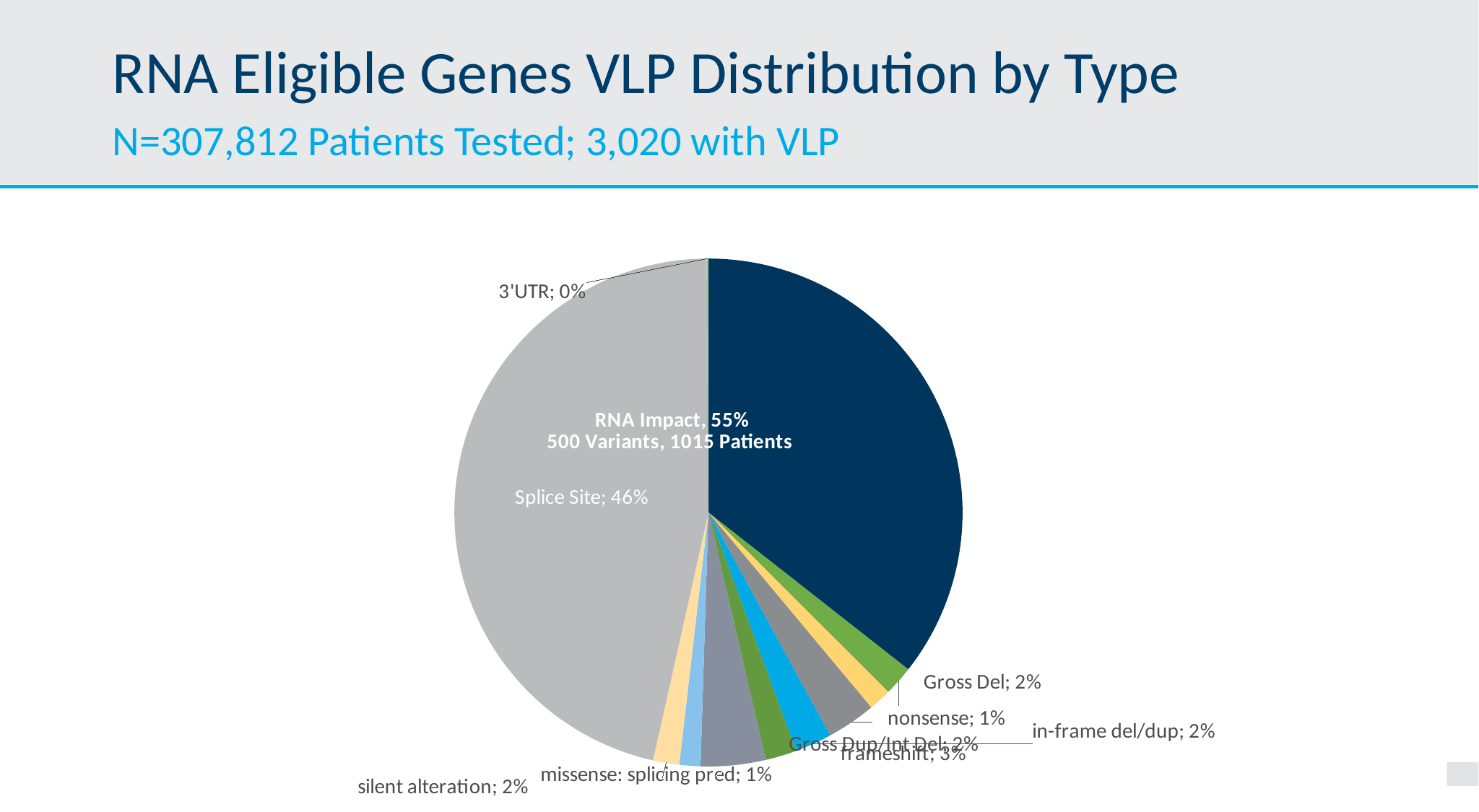
What percentage is shown for frameshift? 3% What percentage is shown for nonsense? 1% What percentage is shown for 3'UTR? 0% What percentage of the pie is labelled Splice Site? 46% What is the difference in percentage points between the RNA Impact share and the Splice Site share? 9 How many variants and patients are listed for the RNA Impact slice? 500 Variants, 1015 Patients What type of chart is shown on the slide? pie chart Which category has the smallest share of the pie? 3'UTR What is the title of the slide containing the pie chart? RNA Eligible Genes VLP Distribution by Type Which is larger, the share for frameshift or the share for Gross Del? frameshift What share of the pie is labelled RNA Impact? 55%